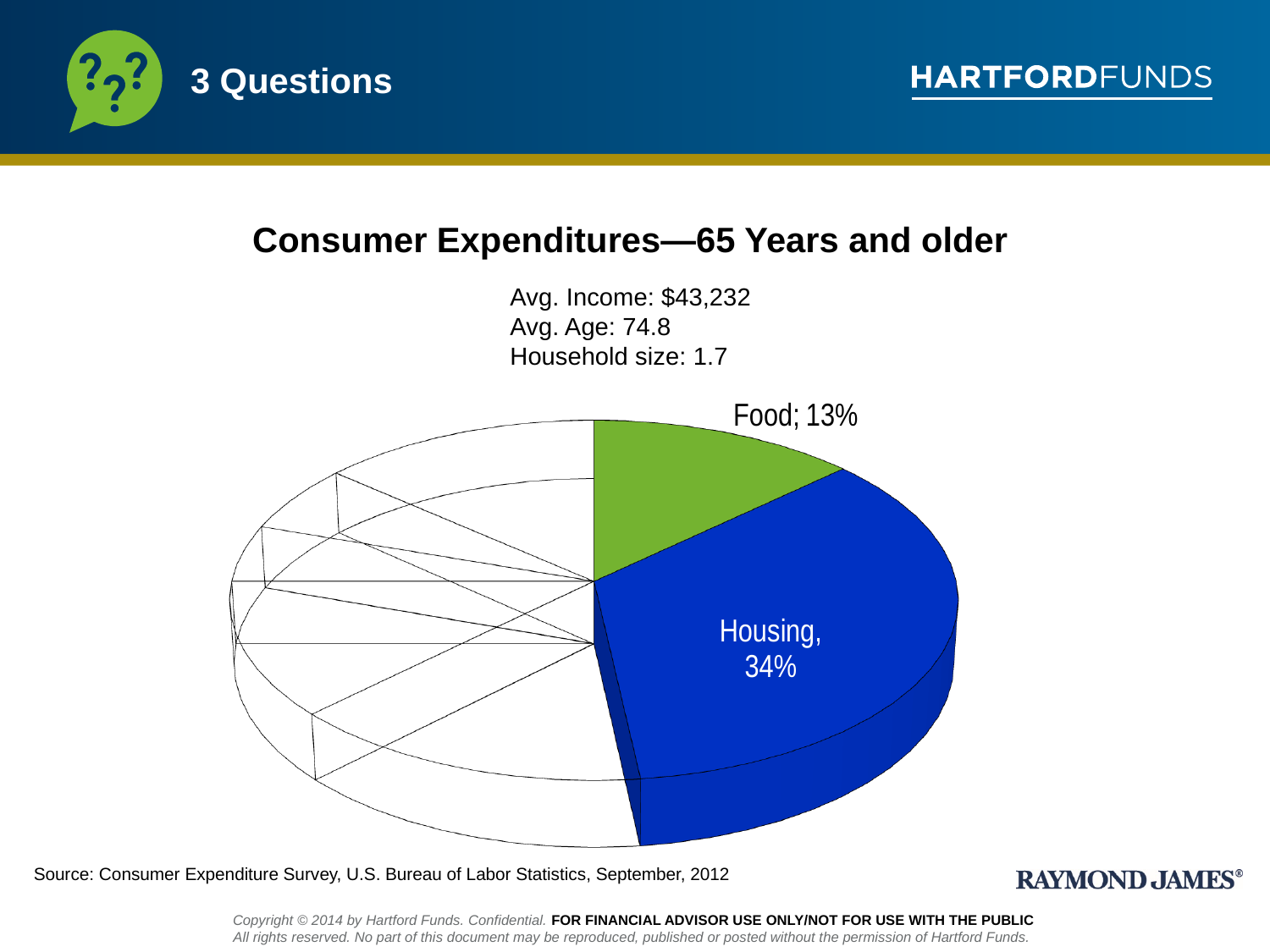
What percentage of consumer expenditures does Food account for in the pie chart? 13% Which is larger in the pie chart, the Housing slice or the Food slice? Housing By how many percentage points does the Housing share exceed the Food share? 21 percentage points What percentage of consumer expenditures does Housing account for in the pie chart? 34% What is the title of the chart on the slide? Consumer Expenditures—65 Years and older What share of the pie does the Housing slice represent? 34% What kind of chart is shown on the slide? Pie chart Is the Food share greater or less than 20%? less Is the Housing share greater or less than 30%? greater What colour is the Food slice in the pie chart? Green